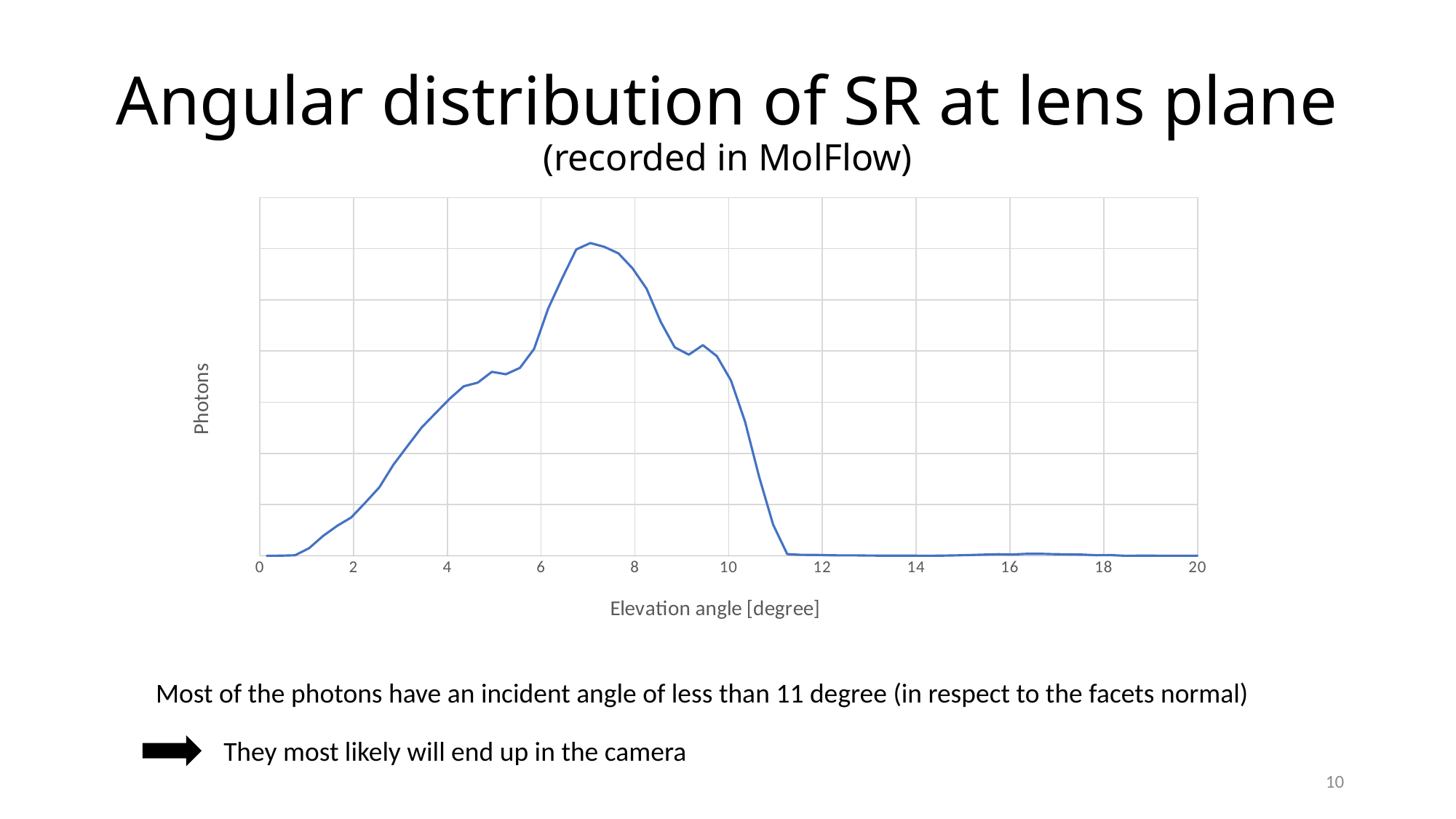
Which has more photons: an elevation angle of 2 degrees or 10 degrees? 10 degrees What kind of chart is shown on the slide? line chart Which has more photons: an elevation angle of 4 degrees or 8 degrees? 8 degrees What is the largest elevation angle value shown on the x axis? 20 Which has more photons: an elevation angle of 6 degrees or 14 degrees? 6 degrees What is the label of the x axis of the chart? Elevation angle [degree] What is the label of the y axis of the chart? Photons How many data series are plotted in the chart? 1 Does the number of photons rise or fall as the elevation angle increases from 8 to 11 degrees? fall Does the number of photons rise or fall as the elevation angle increases from 0 to 6 degrees? rise Is the peak of the photon distribution located between 6 and 8 degrees or between 10 and 12 degrees? between 6 and 8 degrees